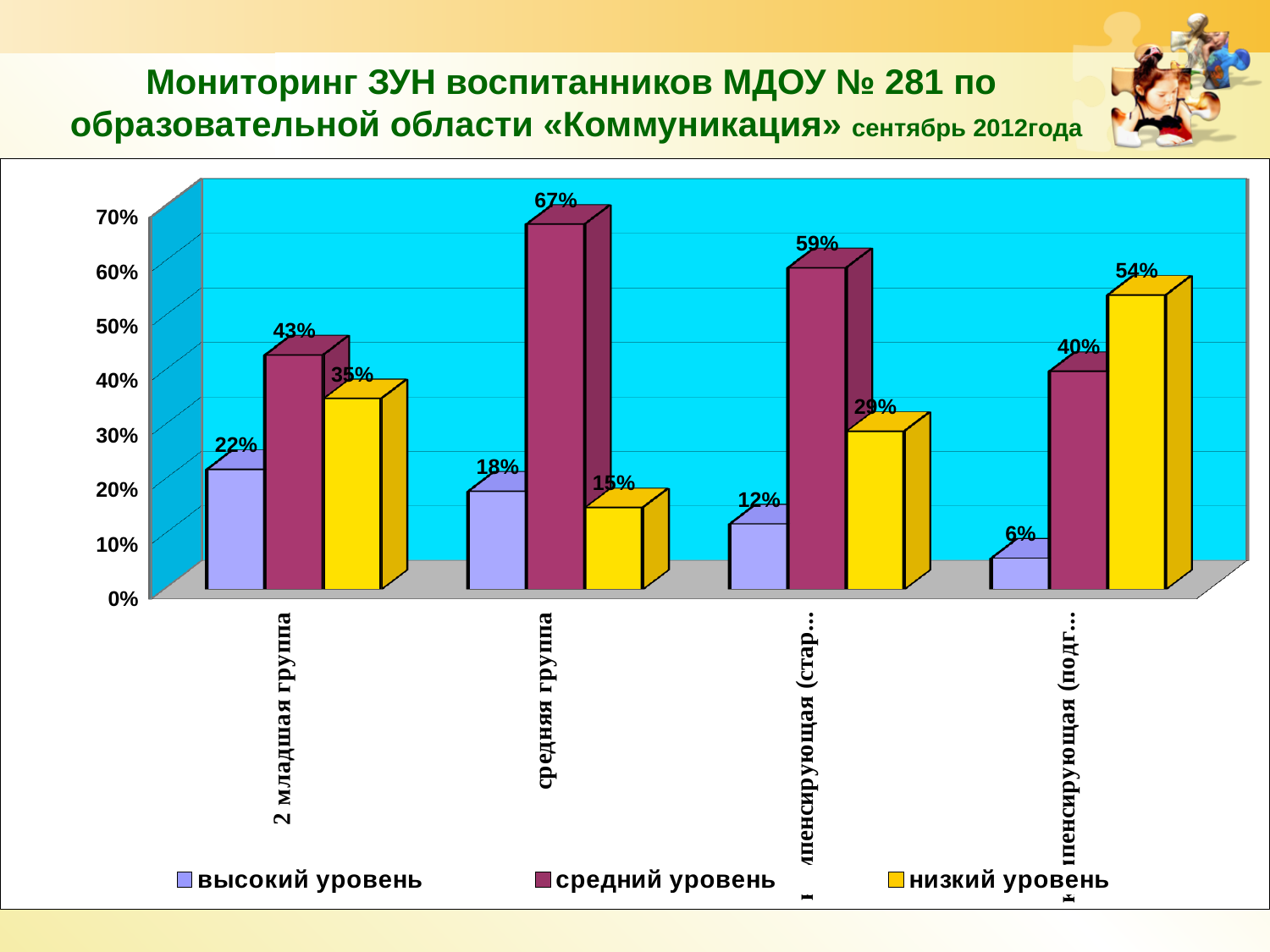
What is the value of "низкий уровень" for the fourth (rightmost) group? 54% What is the value of "низкий уровень" for "средняя группа"? 15% Which series is shown in yellow in the legend? низкий уровень What kind of chart is shown on the slide? bar chart How many series does the legend list? 3 For "средняя группа", which is larger: "высокий уровень" or "низкий уровень"? высокий уровень Which group has the highest value for "средний уровень"? средняя группа What is the difference between "средний уровень" and "высокий уровень" for "2 младшая группа"? 21% What is the value of "высокий уровень" for "средняя группа"? 18% What is the value of "средний уровень" for "2 младшая группа"? 43% Which group has the lowest value for "высокий уровень"? the fourth (rightmost) group How many groups (categories) are shown along the x axis? 4